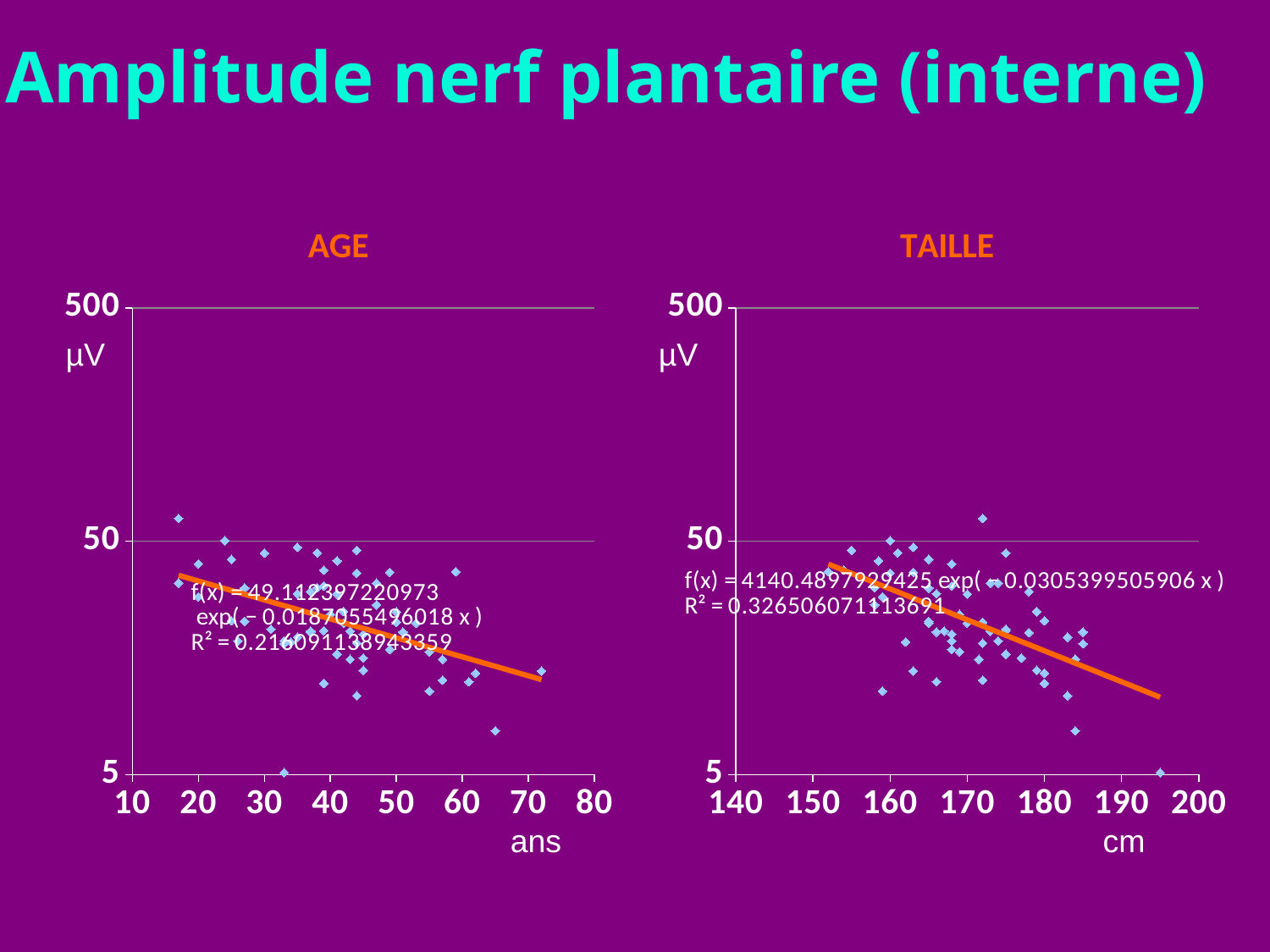
On the TAILLE chart, is the highest plotted point greater or less than 50 µV? greater What kind of chart is the AGE chart on the left? scatter chart On the TAILLE chart, what R² value is printed for the fitted curve? 0.326506071113691 On the AGE chart, is the highest plotted point greater or less than 50 µV? greater What is the title of the slide above the two charts? Amplitude nerf plantaire (interne) What kind of chart is the TAILLE chart on the right? scatter chart What unit is shown on the x axis of the TAILLE chart? cm On the TAILLE chart, what is the leading constant in the printed fit equation? 4140.4897929425 On the TAILLE chart, what is the exponent coefficient in the printed fit equation f(x) = 4140.4897929425 exp( ... x )? -0.0305399505906 On the TAILLE chart, does the fitted trend line rise or fall as height increases along the x axis? fall On the AGE chart, does the fitted trend line rise or fall as age increases along the x axis? fall What is the highest tick value shown on the y axis of the AGE chart? 500